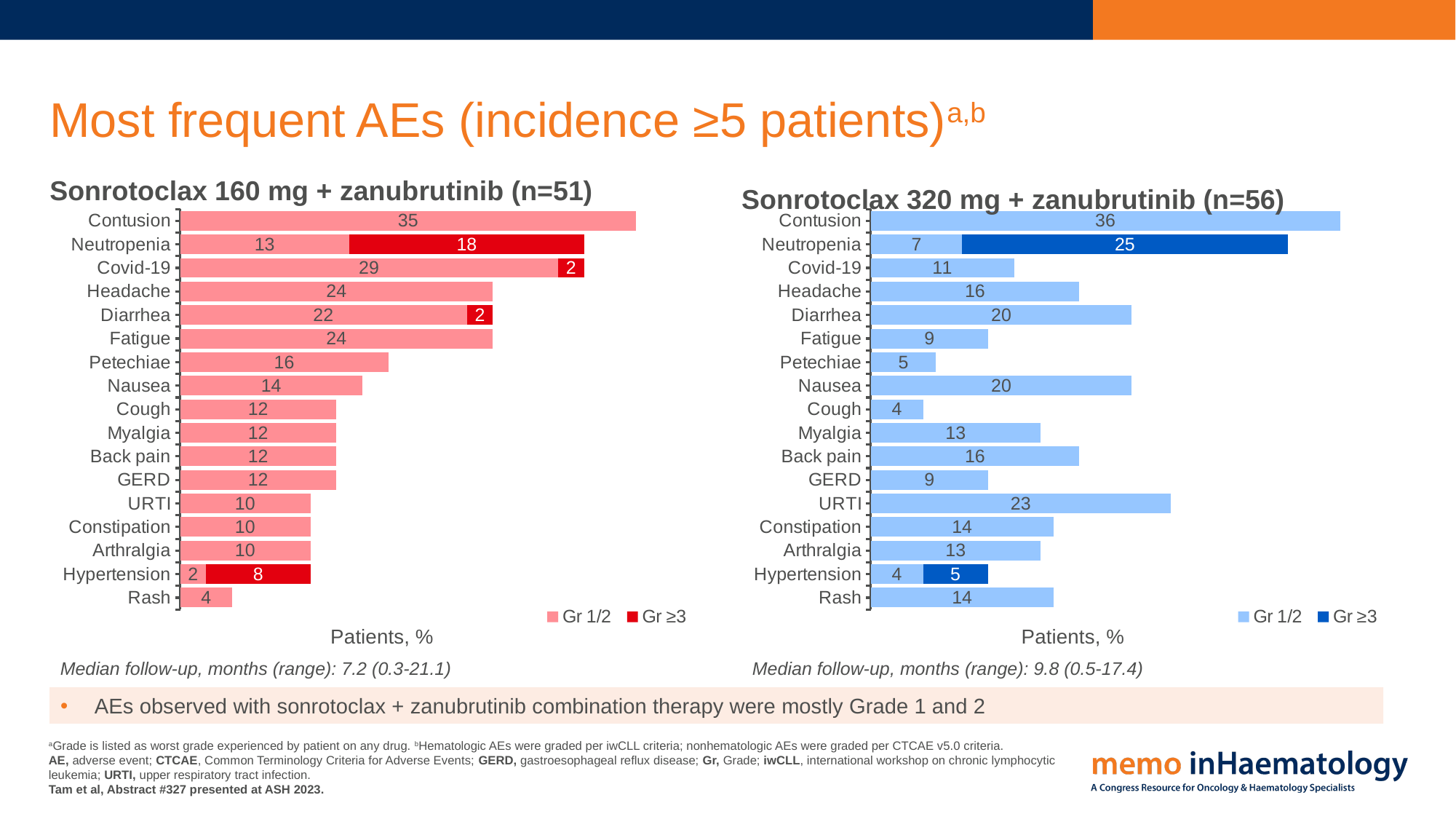
How many series does the legend of the Sonrotoclax 160 mg + zanubrutinib (n=51) chart list? 2 In the Sonrotoclax 320 mg + zanubrutinib (n=56) chart, what is the difference between the Gr ≥3 value for Neutropenia and the Gr ≥3 value for Hypertension? 20 In the Sonrotoclax 160 mg + zanubrutinib (n=51) chart, which adverse event has the highest Gr 1/2 value? Contusion In the Sonrotoclax 160 mg + zanubrutinib (n=51) chart, what is the Gr ≥3 value for Neutropenia? 18 In the Sonrotoclax 320 mg + zanubrutinib (n=56) chart, what is the total of the stacked bar for Hypertension? 9 What kind of chart is the Sonrotoclax 320 mg + zanubrutinib (n=56) chart? Stacked bar chart In the Sonrotoclax 320 mg + zanubrutinib (n=56) chart, which adverse event has the lowest Gr 1/2 value? Cough and Hypertension In the Sonrotoclax 160 mg + zanubrutinib (n=51) chart, what is the total of the stacked bar for Neutropenia? 31 In the Sonrotoclax 160 mg + zanubrutinib (n=51) chart, which is larger: the Gr 1/2 value for Petechiae or the Gr 1/2 value for Nausea? Petechiae In the Sonrotoclax 320 mg + zanubrutinib (n=56) chart, what is the Gr 1/2 value for URTI? 23 What is the x-axis label of the Sonrotoclax 160 mg + zanubrutinib (n=51) chart? Patients, % How many adverse event categories are listed in the Sonrotoclax 320 mg + zanubrutinib (n=56) chart? 17